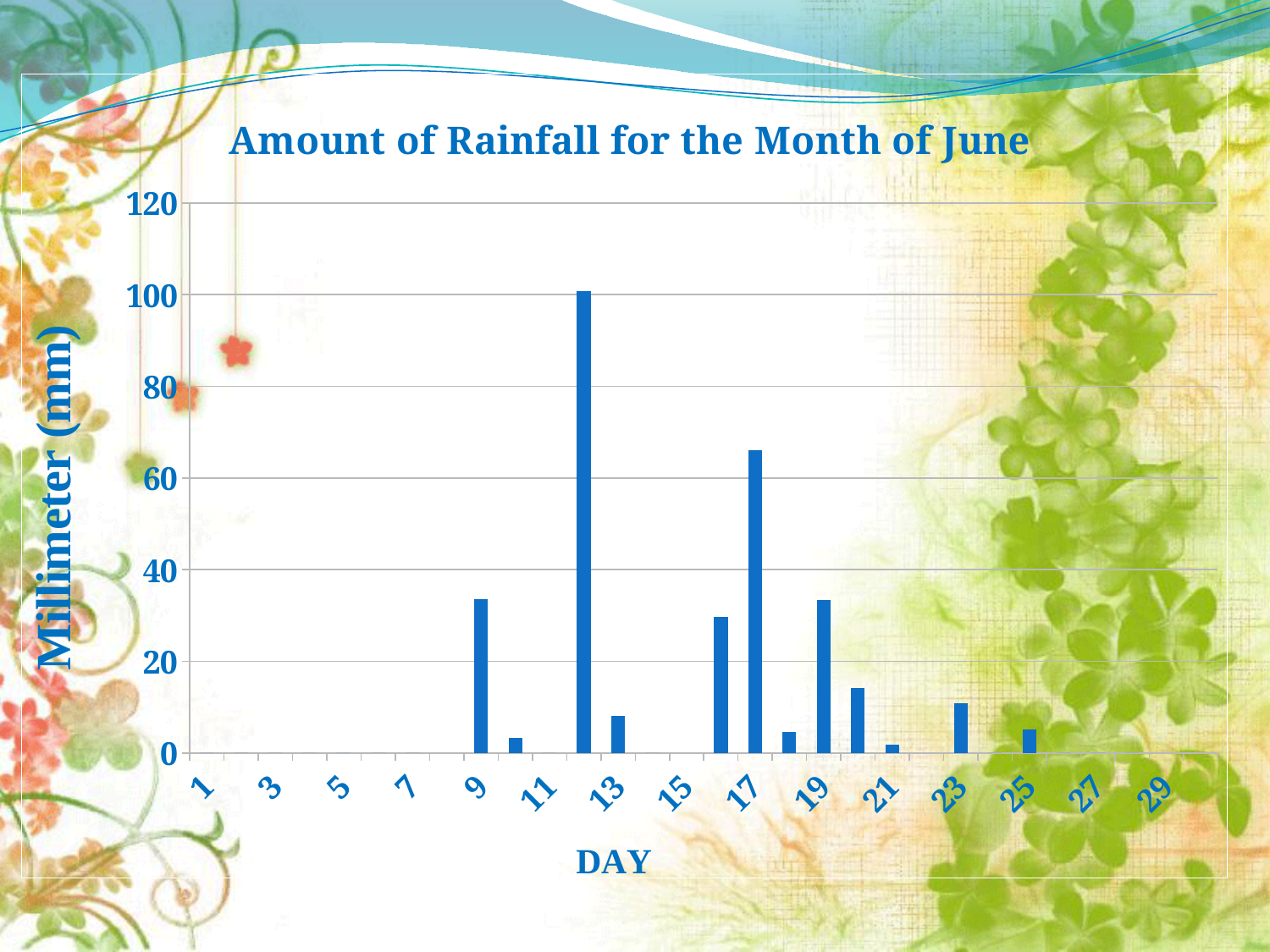
Is the rainfall on day 9 greater or less than 40? less How many days show a visible rainfall bar on the chart? 12 What kind of chart is shown on the slide? bar chart Which day has more rainfall, day 17 or day 9? 17 Is the rainfall on day 16 greater or less than 20? greater Is the rainfall on day 20 greater or less than 20? less Which day has more rainfall, day 12 or day 17? 12 What is the title of the chart? Amount of Rainfall for the Month of June Which day has the highest rainfall? 12 What is the label of the vertical axis? Millimeter (mm)